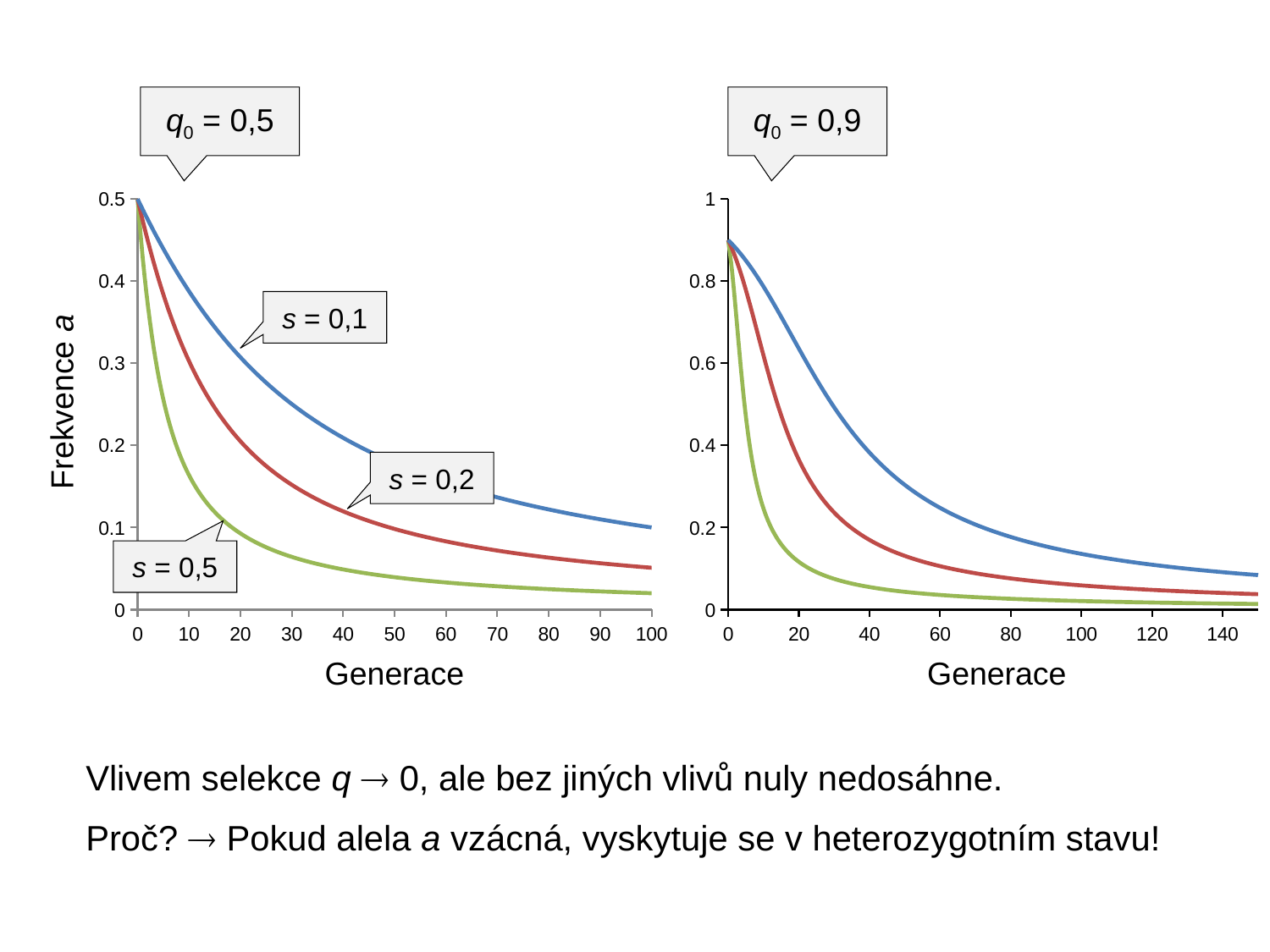
On the left chart (q0 = 0,5), how many curves are plotted? 3 On the left chart (q0 = 0,5), what is the frequency of allele a at generation 0? 0.5 On the left chart (q0 = 0,5), do the curves rise or fall as the generation number increases? fall What is the label of the x axis on both charts? Generace On the left chart (q0 = 0,5), what colour is the s = 0,5 curve? green What type of chart is shown on the left (q0 = 0,5)? line chart On the right chart (q0 = 0,9), what is the initial frequency of allele a at generation 0? 0,9 On the left chart (q0 = 0,5), at generation 20, which curve has the higher value: s = 0,1 or s = 0,5? s = 0,1 On the right chart (q0 = 0,9), is the value of the blue curve at generation 100 greater or less than 0.2? less On the left chart (q0 = 0,5), which curve has the lowest value at generation 50? s = 0,5 On the left chart (q0 = 0,5), is the value of the s = 0,5 curve at generation 40 greater or less than 0.1? less